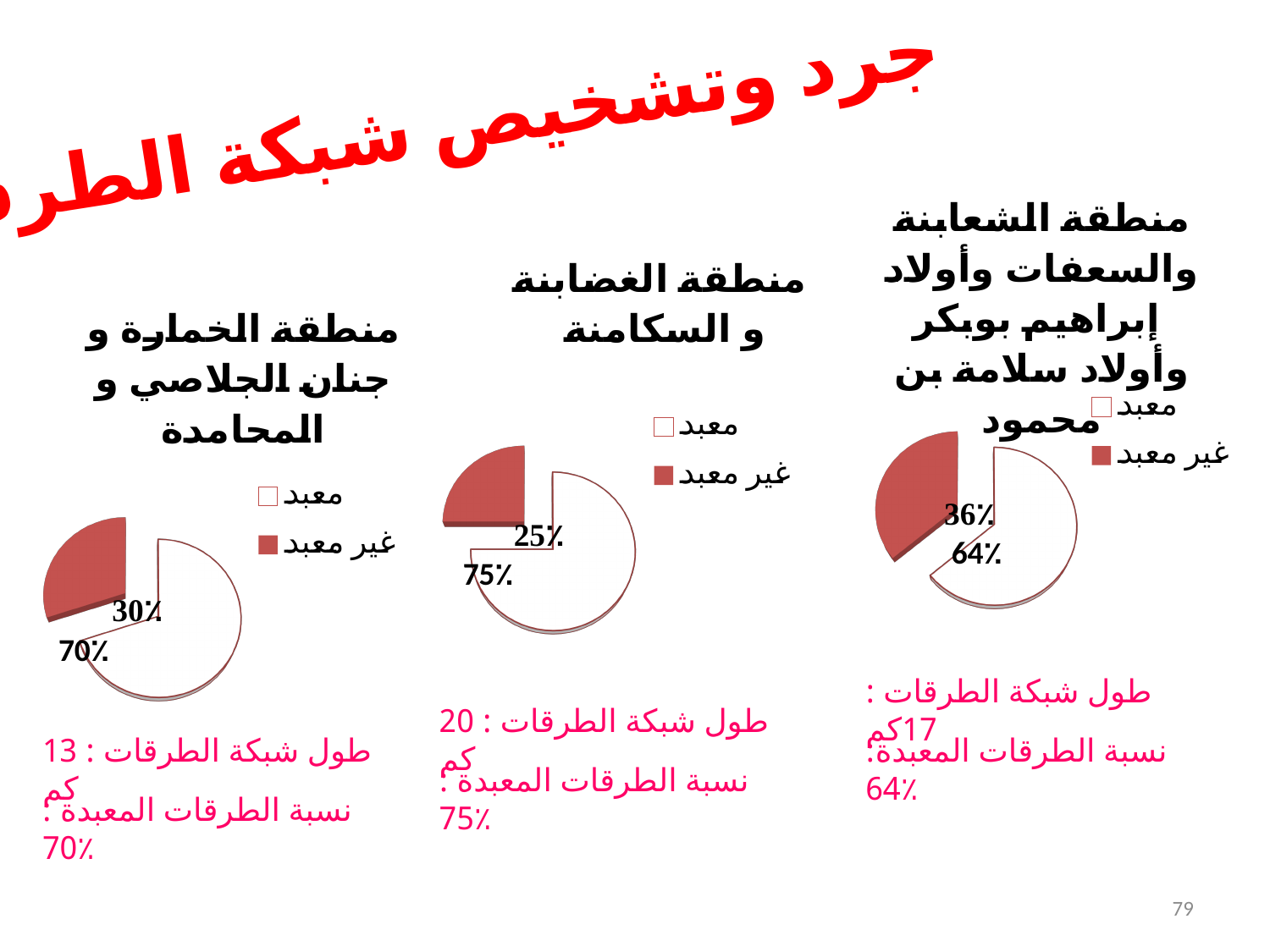
In the right pie chart (منطقة الشعابنة والسعفات), which slice is larger, معبد or غير معبد? معبد What kind of chart is used on the left of the slide for منطقة الخمارة و جنان الجلاصي و المحامدة? pie chart In the right pie chart (منطقة الشعابنة والسعفات), what share is labelled for غير معبد? 36% In the left pie chart, which colour is used for the غير معبد slice? red In the left pie chart (منطقة الخمارة و جنان الجلاصي و المحامدة), what share is labelled for غير معبد? 30% How many slices does the middle pie chart (منطقة الغضابنة و السكامنة) have? 2 In the left pie chart (منطقة الخمارة و جنان الجلاصي و المحامدة), what share is labelled for معبد? 70% In the middle pie chart (منطقة الغضابنة و السكامنة), what share is labelled for معبد? 75% In the right pie chart (منطقة الشعابنة والسعفات), what is the difference between the معبد share and the غير معبد share? 28% How many entries does the legend of the left pie chart list? 2 In the middle pie chart (منطقة الغضابنة و السكامنة), what share is labelled for غير معبد? 25% In the right pie chart (منطقة الشعابنة والسعفات), what share is labelled for معبد? 64%